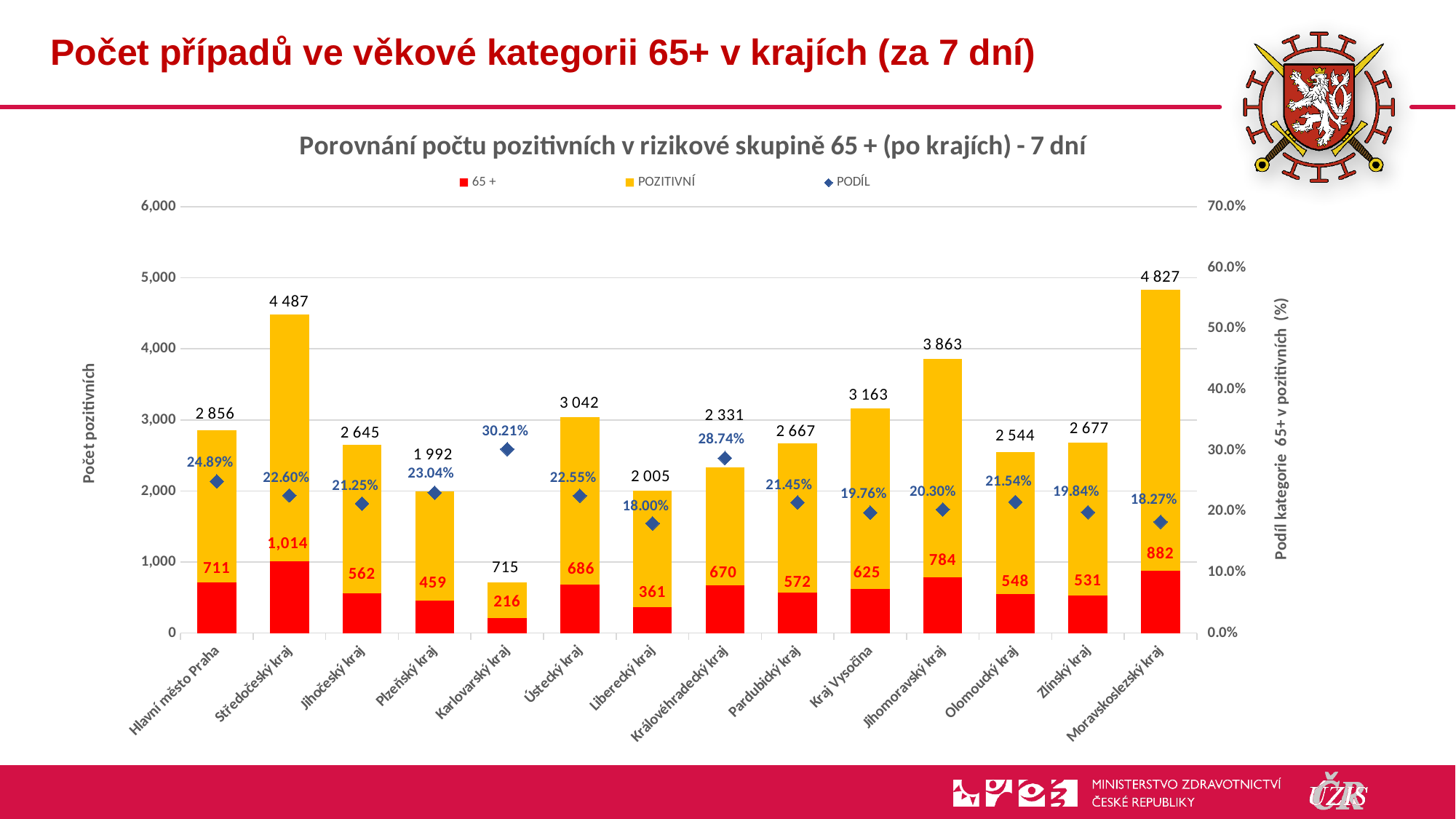
Which region has the lowest PODÍL value? Liberecký kraj What is the difference between the POZITIVNÍ values for Středočeský kraj and Jihomoravský kraj? 624 What is the POZITIVNÍ value for Moravskoslezský kraj? 4 827 What is the PODÍL value for Karlovarský kraj? 30.21% What is the 65 + value for Středočeský kraj? 1,014 How many regions are shown on the x axis? 14 How many series does the legend list? 3 What kind of chart is this? Bar chart with a line/marker series Which region has the highest POZITIVNÍ value? Moravskoslezský kraj Which region has the lowest 65 + value? Karlovarský kraj Which is larger, the 65 + value for Ústecký kraj or for Královéhradecký kraj? Ústecký kraj What is the title of the chart? Porovnání počtu pozitivních v rizikové skupině 65 + (po krajích) - 7 dní